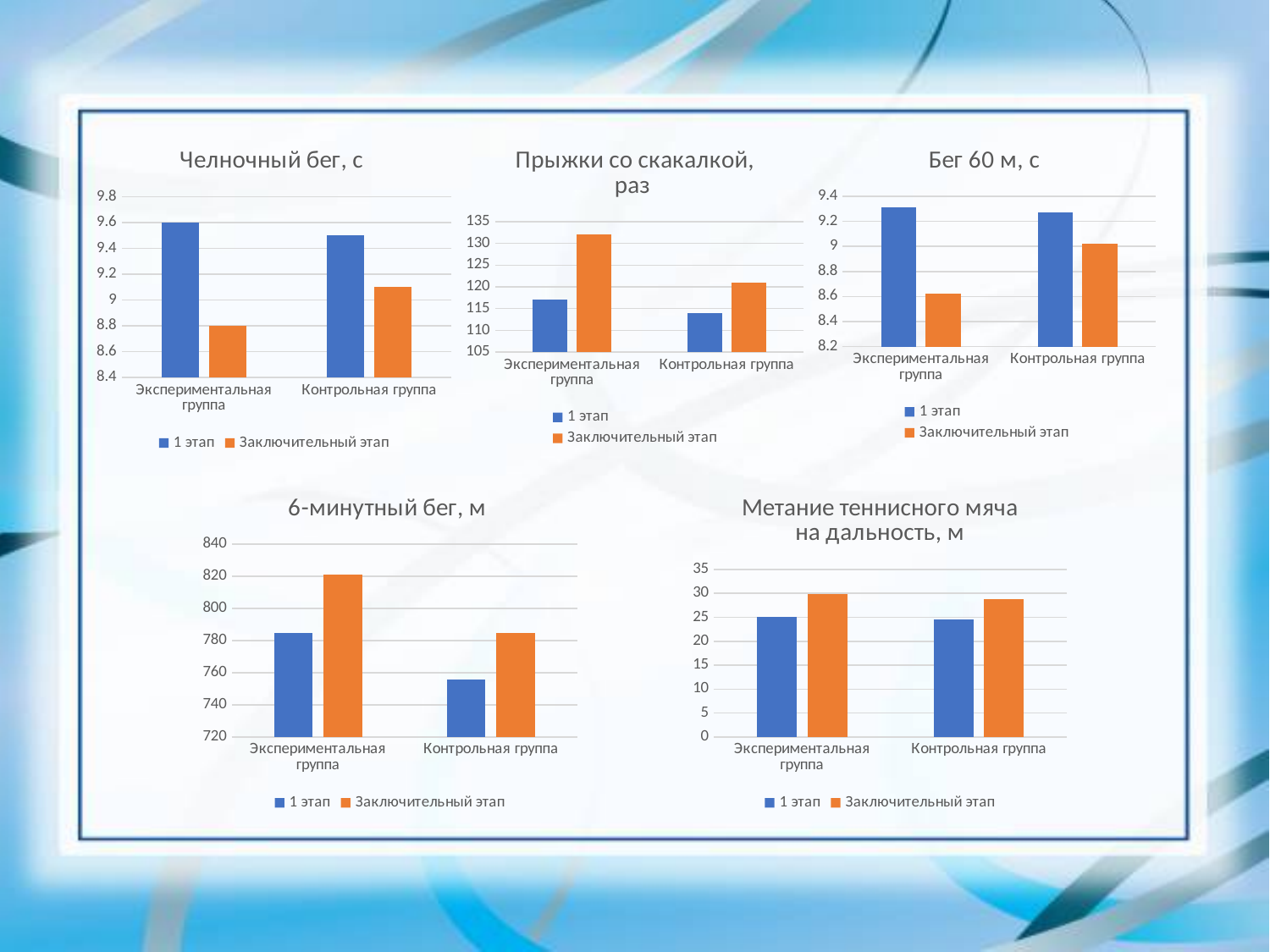
In the chart titled "Челночный бег, с", what is the value for Экспериментальная группа in the Заключительный этап series? 8.8 In the chart titled "Бег 60 м, с", is the 1 этап value for Экспериментальная группа greater or less than 9.2? greater How many series does the legend of the chart titled "6-минутный бег, м" list? 2 In the chart titled "Прыжки со скакалкой, раз", is the Заключительный этап value for Экспериментальная группа greater or less than 130? greater In the chart titled "Челночный бег, с", what is the difference between the 1 этап and Заключительный этап values for Экспериментальная группа? 0.8 In the chart titled "Челночный бег, с", which is larger for Контрольная группа: the 1 этап value or the Заключительный этап value? 1 этап In the chart titled "6-минутный бег, м", which bar is the lowest? Контрольная группа, 1 этап What kind of chart is the chart titled "Бег 60 м, с"? bar chart In the chart titled "6-минутный бег, м", is the 1 этап value for Контрольная группа greater or less than 760? less In the chart titled "Прыжки со скакалкой, раз", which bar is the highest? Экспериментальная группа, Заключительный этап In the chart titled "Челночный бег, с", what is the value for Экспериментальная группа in the 1 этап series? 9.6